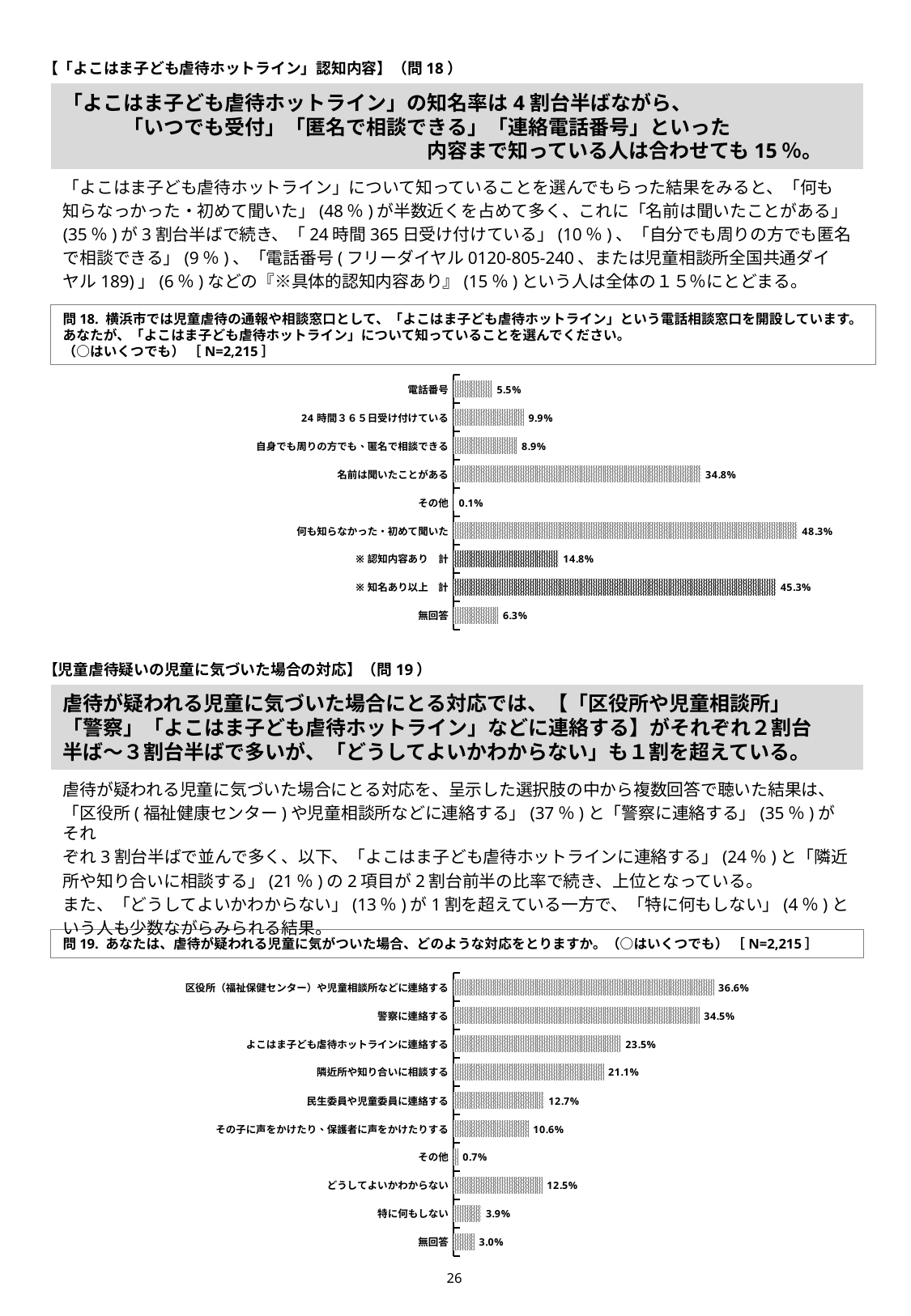
In the 問19 chart (bottom), which category has the highest value? 区役所（福祉保健センター）や児童相談所などに連絡する What kind of chart is the 問19 chart (bottom)? Bar chart In the 問18 chart (top), what is the value for 「電話番号」? 5.5% In the 問19 chart (bottom), what is the difference between 「よこはま子ども虐待ホットラインに連絡する」 and 「隣近所や知り合いに相談する」? 2.4% In the 問19 chart (bottom), how many categories are plotted? 10 In the 問19 chart (bottom), what is the value for 「警察に連絡する」? 34.5% In the 問18 chart (top), what is the value for 「何も知らなかった・初めて聞いた」? 48.3% In the 問19 chart (bottom), what is the value for 「どうしてよいかわからない」? 12.5% In the 問18 chart (top), what is the difference between 「名前は聞いたことがある」 and 「24時間365日受け付けている」? 24.9% In the 問18 chart (top), how many categories are plotted? 9 In the 問18 chart (top), which category has the lowest value? その他 In the 問18 chart (top), which is larger: 「24時間365日受け付けている」 or 「自身でも周りの方でも、匿名で相談できる」? 24時間365日受け付けている